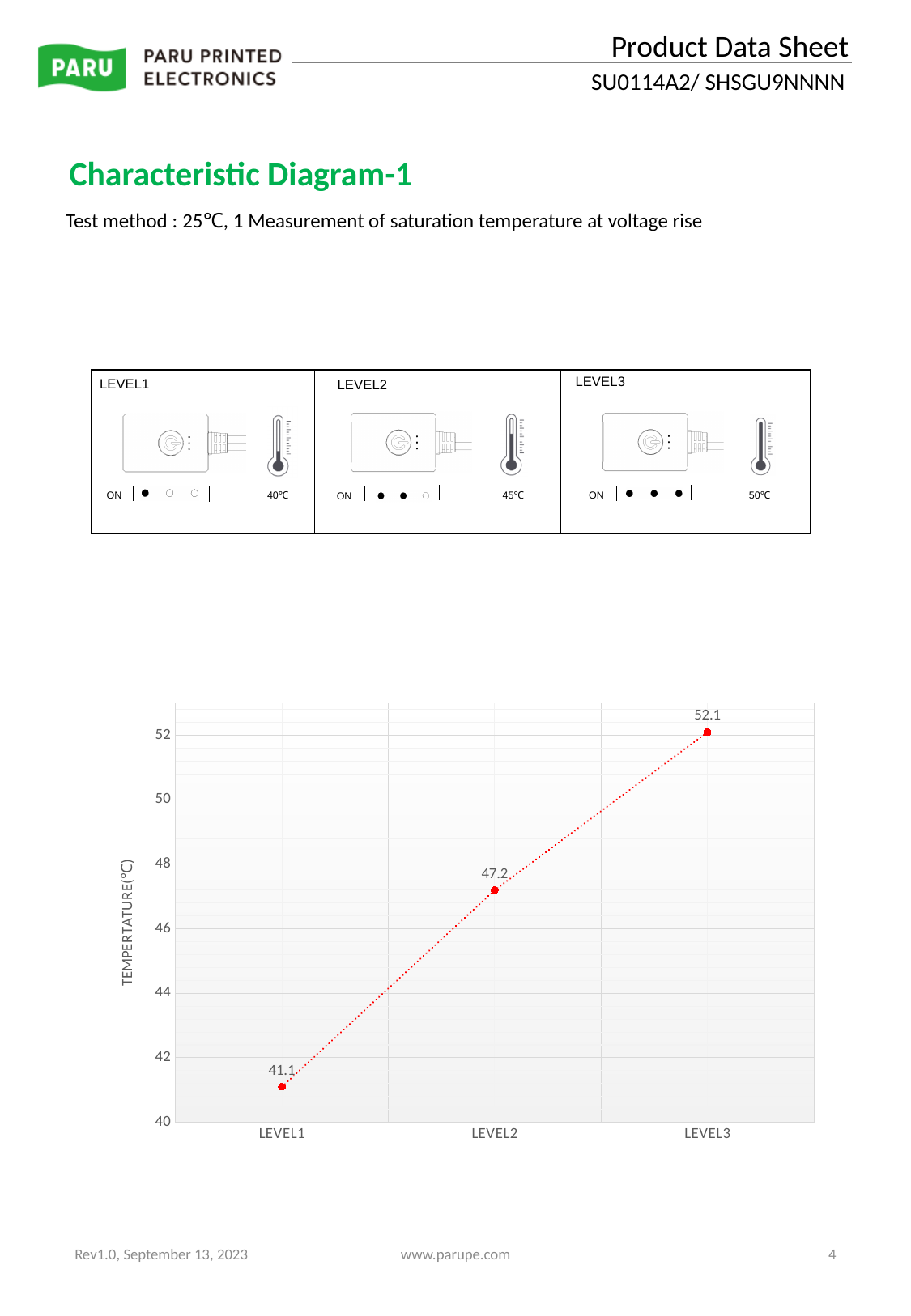
Which level has the highest temperature? LEVEL3 What is the temperature value for LEVEL3? 52.1 Is the value for LEVEL2 greater or less than 46? greater What is the temperature value for LEVEL2? 47.2 How many levels are plotted on the x axis? 3 What is the label of the y axis? TEMPERTATURE(°C) Do the temperature values rise or fall from LEVEL1 to LEVEL3? rise What is the temperature value for LEVEL1? 41.1 Which has a higher temperature, LEVEL2 or LEVEL3? LEVEL3 Which level has the lowest temperature? LEVEL1 What is the difference between the temperature at LEVEL3 and at LEVEL1? 11 What is the difference between the temperature at LEVEL2 and at LEVEL1? 6.1